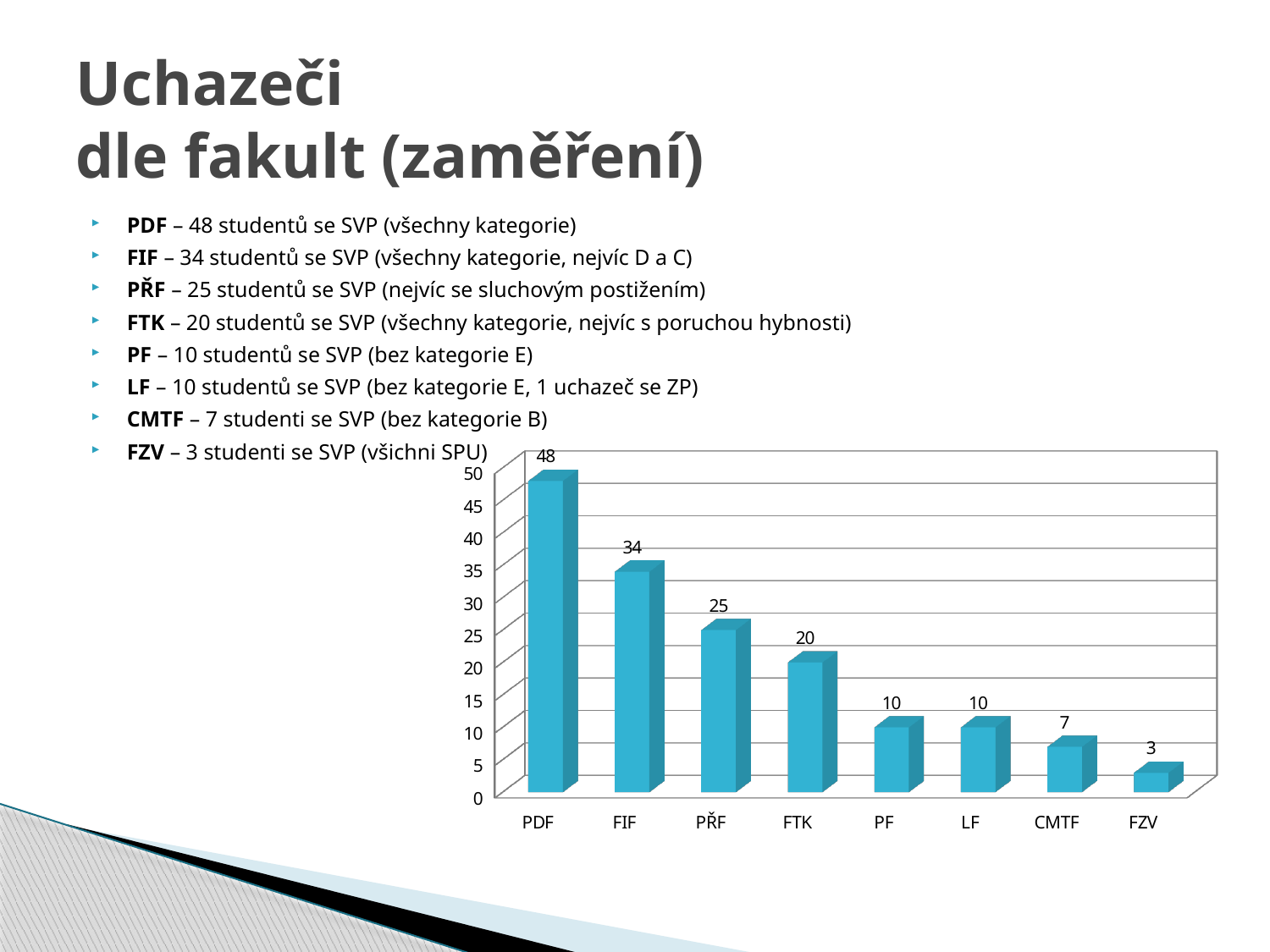
What is the value for PŘF? 25 What kind of chart is this? bar chart Which category has the highest value? PDF Is the value for FTK greater or less than 15? greater Which category has the lowest value? FZV What is the difference between the values for FTK and FZV? 17 Which is larger, the value for FIF or the value for PŘF? FIF Do the values rise or fall from left to right along the x axis? fall What is the difference between the values for PDF and FIF? 14 What is the value for CMTF? 7 What is the value for PDF? 48 How many categories are shown on the x axis? 8